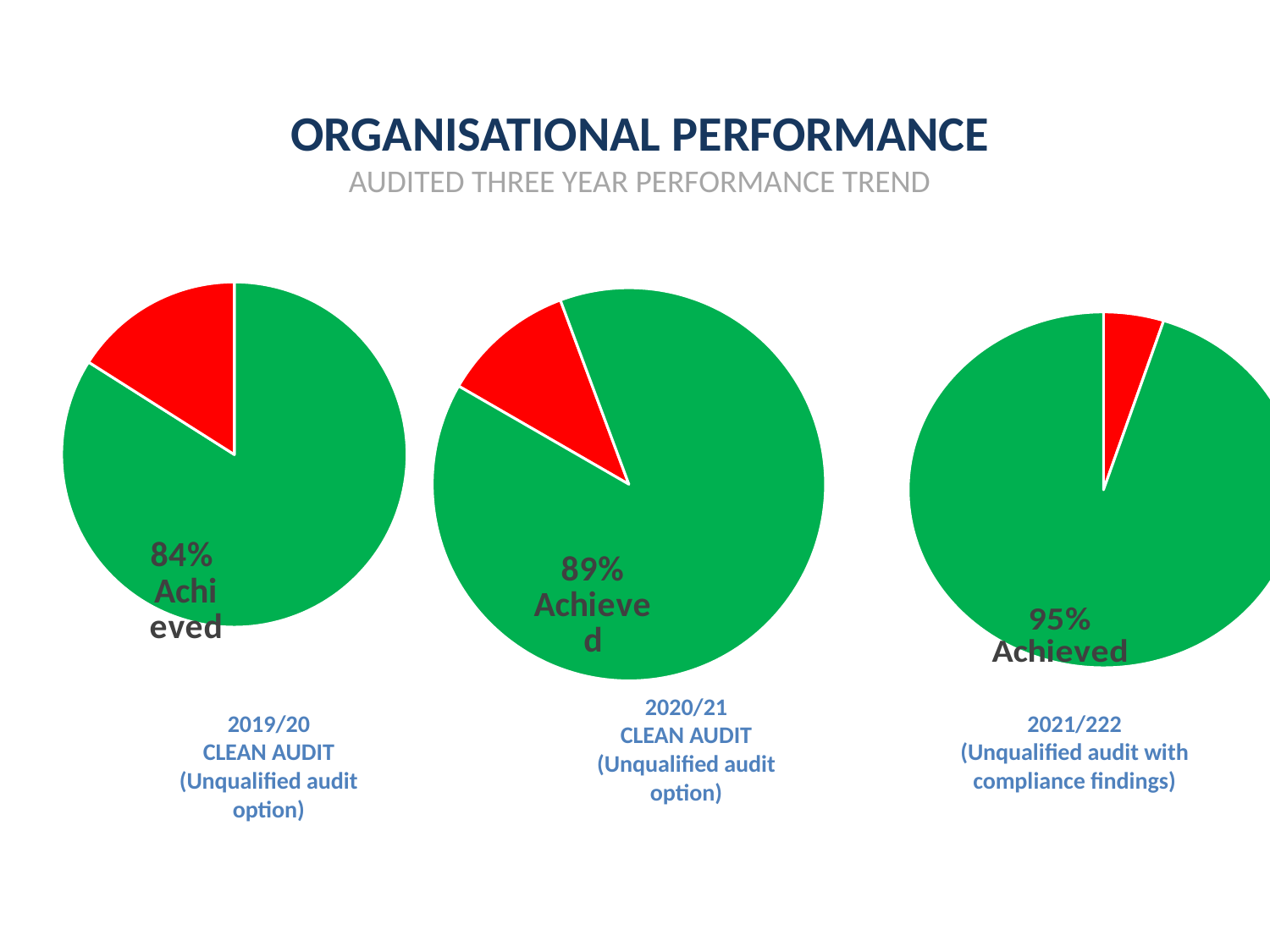
What percentage was achieved in the 2019/20 pie chart (left)? 84% What is the difference between the achieved percentage in the 2021/22 chart and the 2019/20 chart? 11% What is the difference between the achieved percentage in the 2020/21 chart and the 2019/20 chart? 5% What kind of charts are shown on the slide? Pie charts What percentage was achieved in the 2021/22 pie chart (right)? 95% Does the achieved percentage rise or fall from the 2019/20 chart to the 2021/22 chart? Rise Which is larger: the achieved percentage in the 2020/21 chart or the 2021/22 chart? 2021/22 Which year's pie chart shows the lowest achieved percentage? 2019/20 What colour is the achieved slice in each pie chart? Green Which year's pie chart shows the highest achieved percentage? 2021/22 What percentage was achieved in the 2020/21 pie chart (middle)? 89% How many pie charts are on the slide? 3